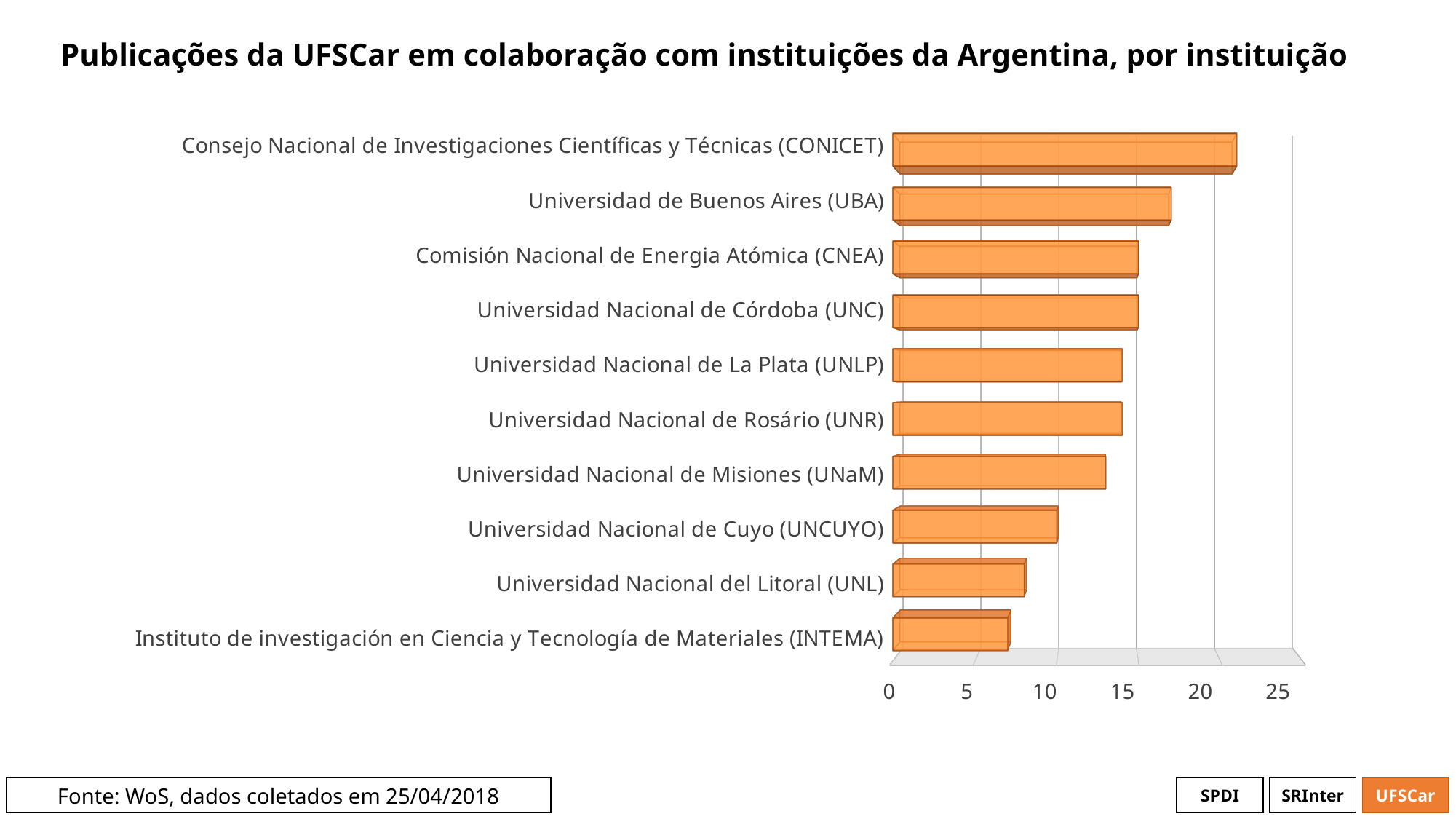
Is the value for Consejo Nacional de Investigaciones Científicas y Técnicas (CONICET) greater or less than 20? greater Which has more publications: Universidad de Buenos Aires (UBA) or Universidad Nacional de Cuyo (UNCUYO)? Universidad de Buenos Aires (UBA) Is the value for Instituto de investigación en Ciencia y Tecnología de Materiales (INTEMA) greater or less than 5? greater How many institutions are listed in the chart? 10 Is the value for Universidad Nacional de Misiones (UNaM) greater or less than 15? less Which institution has the lowest number of publications in collaboration with UFSCar? Instituto de investigación en Ciencia y Tecnología de Materiales (INTEMA) What is the title of the chart? Publicações da UFSCar em colaboração com instituições da Argentina, por instituição Which institution has the highest number of publications in collaboration with UFSCar? Consejo Nacional de Investigaciones Científicas y Técnicas (CONICET) What kind of chart is shown on the slide? bar chart Do the bar values increase or decrease from the top of the chart to the bottom? decrease